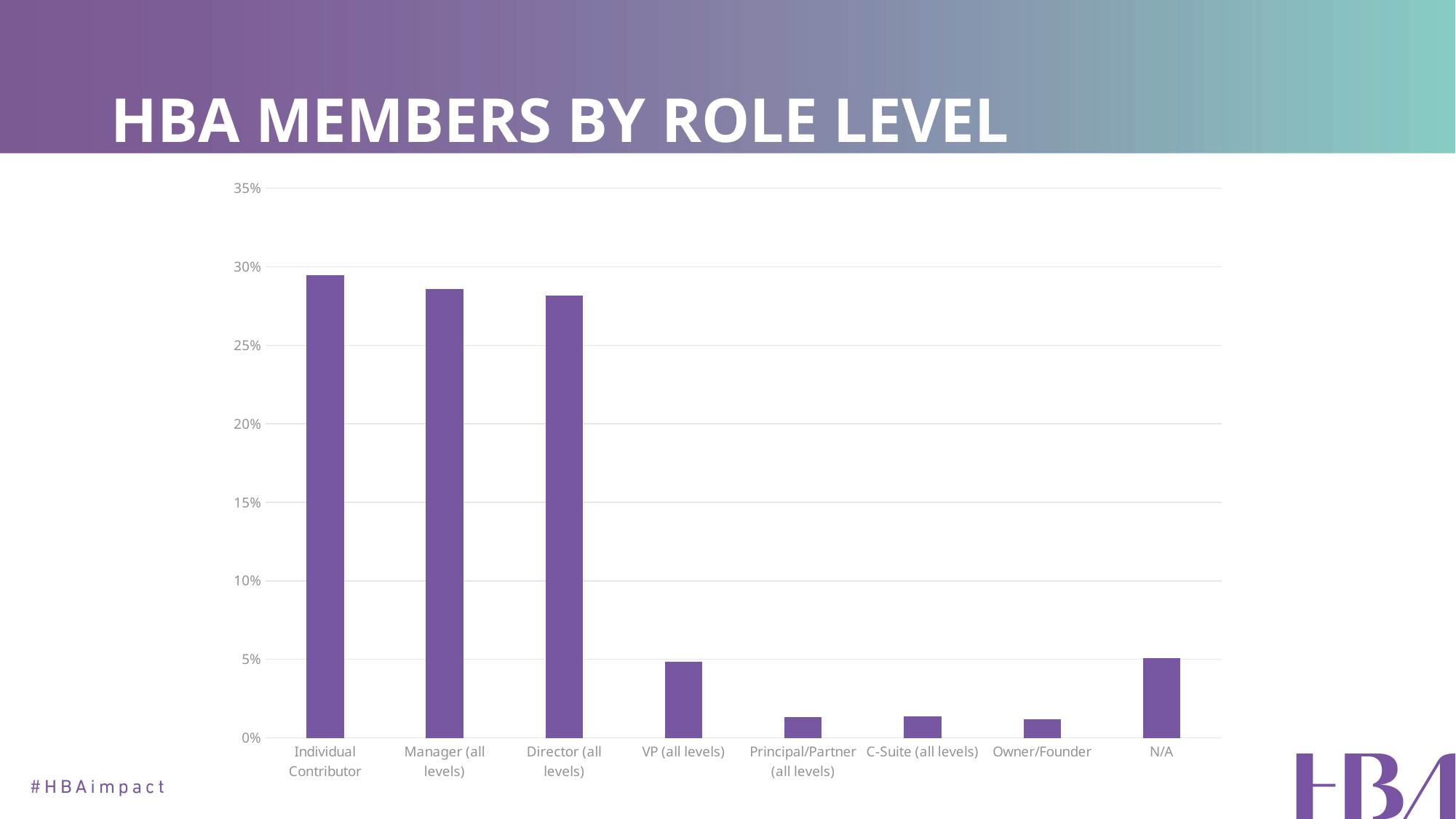
Is the value for Director (all levels) greater or less than 20%? greater Is the value for Principal/Partner (all levels) greater or less than 5%? less Is the value for Individual Contributor greater or less than 25%? greater How many role-level categories are shown on the x axis? 8 Which is larger, the value for Director (all levels) or the value for N/A? Director (all levels) What colour are the bars in the chart? purple Which role level has the highest share of HBA members? Individual Contributor What is the title of the chart? HBA MEMBERS BY ROLE LEVEL Which is larger, the value for Individual Contributor or the value for VP (all levels)? Individual Contributor What kind of chart is shown on the slide? bar chart